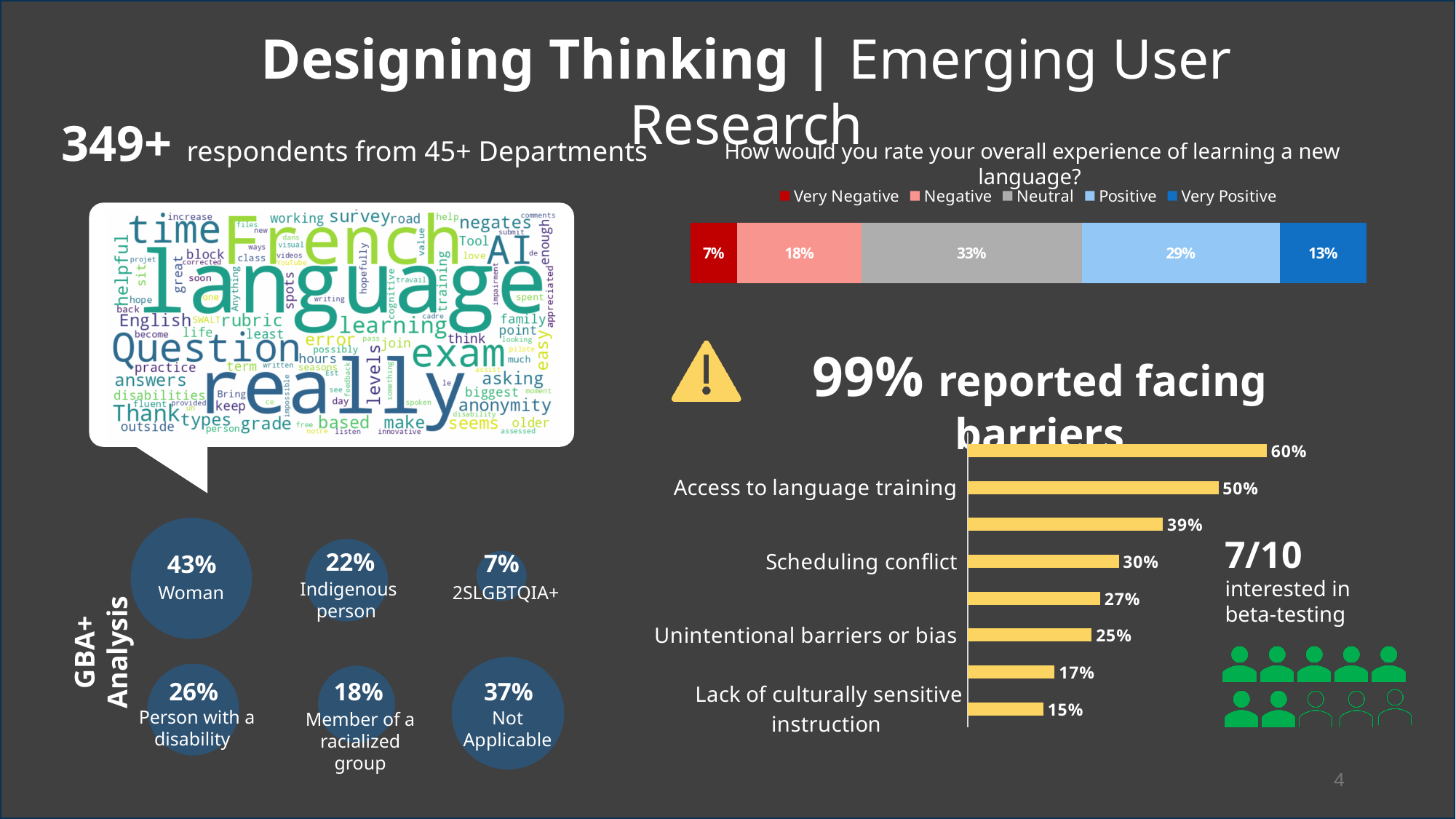
In the chart 'How would you rate your overall experience of learning a new language?', which response category has the largest share? Neutral In the chart 'How would you rate your overall experience of learning a new language?', which response category has the smallest share? Very Negative In the chart 'How would you rate your overall experience of learning a new language?', what is the total of all segments in the stacked bar? 100% In the barriers bar chart on the right, how many bars are plotted? 8 In the chart 'How would you rate your overall experience of learning a new language?', how many series does the legend list? 5 In the chart 'How would you rate your overall experience of learning a new language?', what percentage of respondents answered Neutral? 33% In the barriers bar chart on the right, what is the value for 'Scheduling conflict'? 30% In the barriers bar chart on the right, what is the value for 'Access to language training'? 50% In the chart 'How would you rate your overall experience of learning a new language?', what percentage answered Very Positive? 13% In the chart 'How would you rate your overall experience of learning a new language?', what is the difference between the Positive and Negative shares? 11% What kind of chart is the barriers chart on the right of the slide? Bar chart In the barriers bar chart on the right, what is the value for 'Lack of culturally sensitive instruction'? 15%